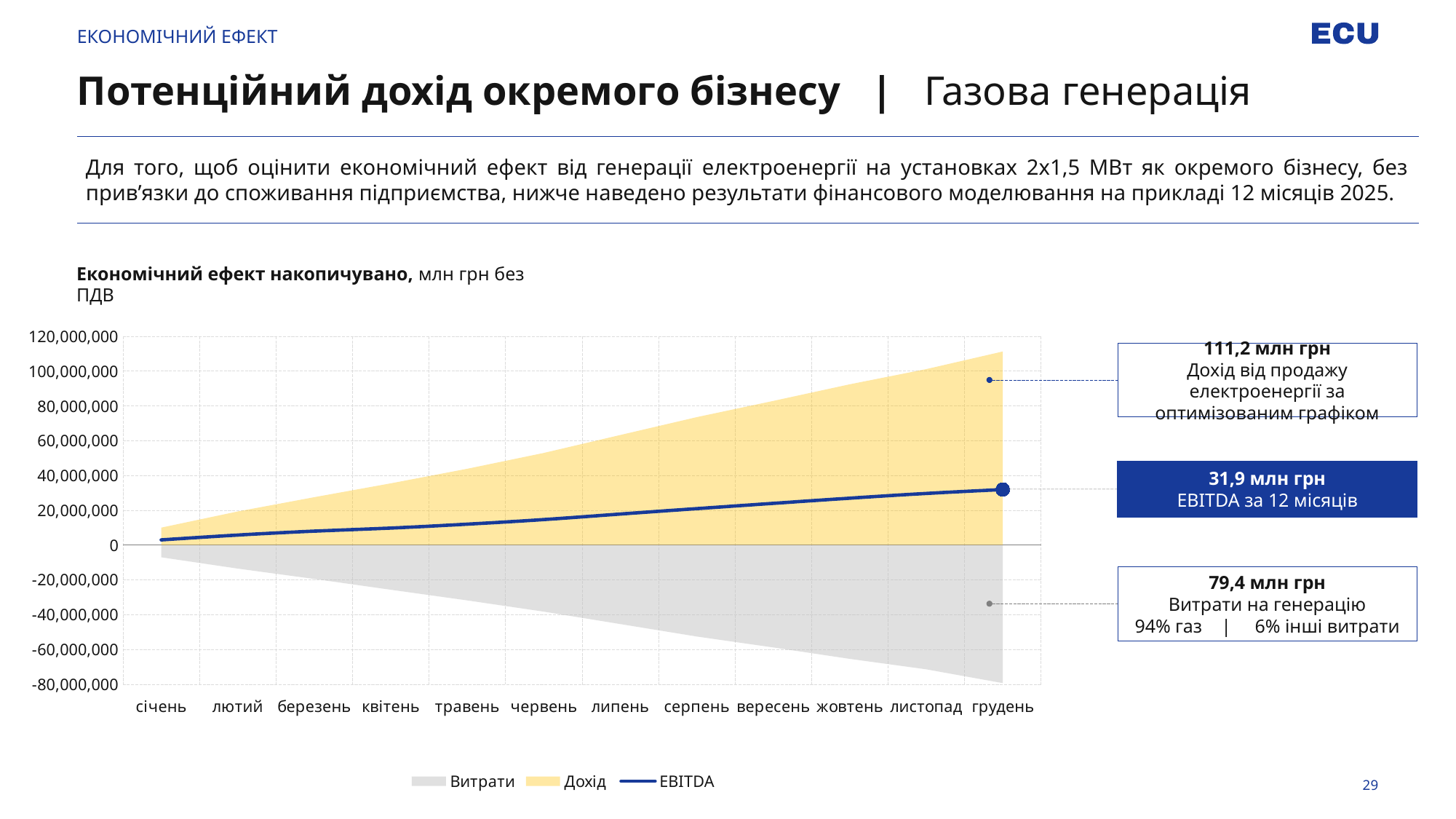
Is the EBITDA value for грудень greater or less than 20,000,000? greater What are the generation costs (Витрати на генерацію) shown in the callout on the chart? 79,4 млн грн Is the cumulative Дохід value for грудень greater or less than 100,000,000? greater Does the EBITDA line rise or fall from січень to грудень? rises What is the revenue from electricity sales (Дохід) shown in the callout at the end of the chart? 111,2 млн грн What is the EBITDA for 12 months shown in the callout on the chart? 31,9 млн грн How many months are shown on the x axis of the chart? 12 What are the three series listed in the chart legend? Витрати, Дохід, EBITDA According to the callout, what share of generation costs is gas? 94% How many series does the chart legend list? 3 Which is larger in the callouts: the revenue (Дохід) or the generation costs (Витрати)? Дохід (111,2 млн грн) Is the EBITDA value for січень greater or less than 20,000,000? less